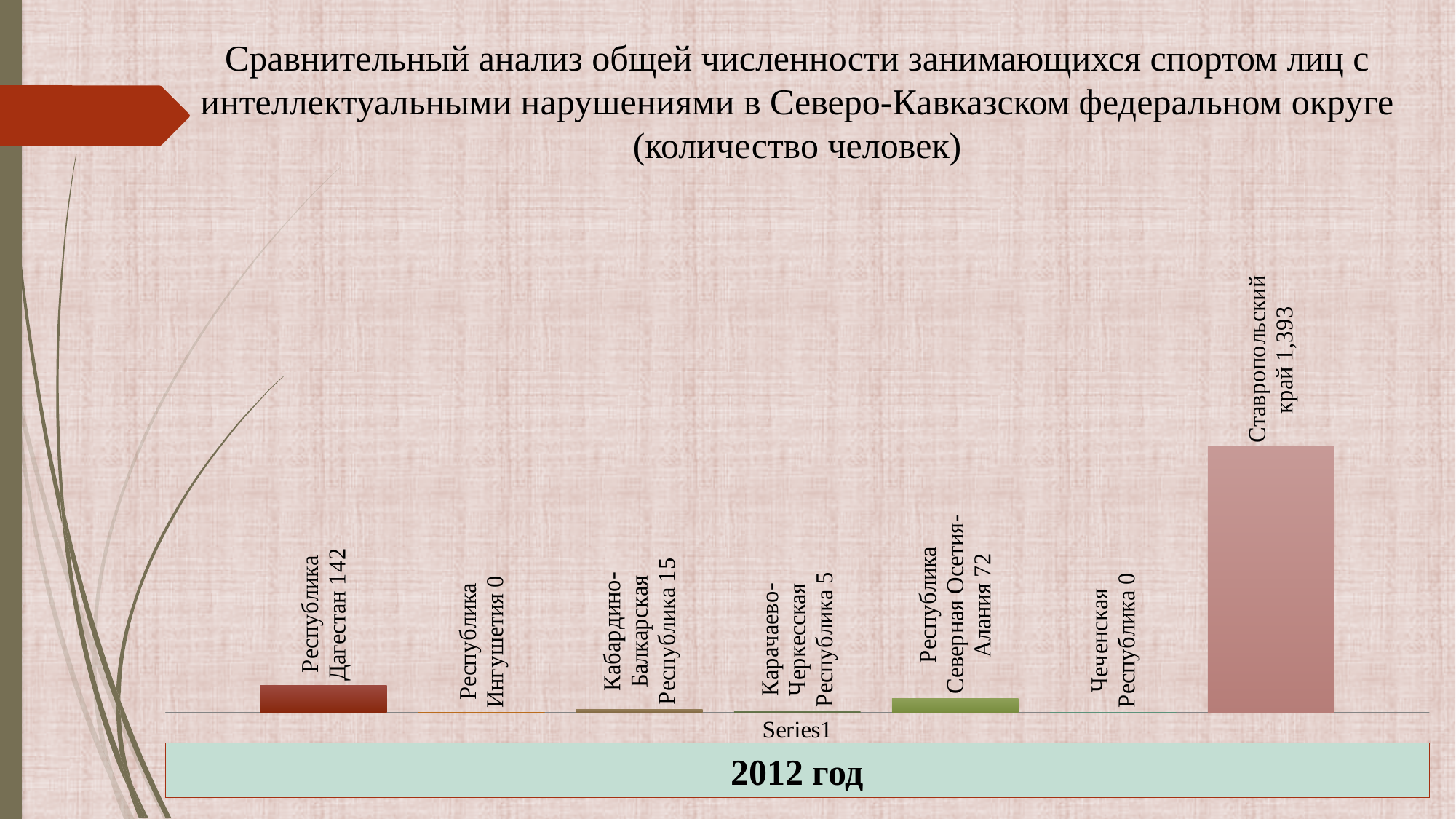
What is the value for Республика Северная Осетия-Алания? 72 What is the difference between the values for Республика Дагестан and Республика Северная Осетия-Алания? 70 Which is larger, the value for Кабардино-Балкарская Республика or Карачаево-Черкесская Республика? Кабардино-Балкарская Республика What is the value for Кабардино-Балкарская Республика? 15 Which regions have a value of 0 in the chart? Республика Ингушетия and Чеченская Республика What type of chart is shown on the slide? bar chart Which region has the highest value in the chart? Ставропольский край What year is indicated in the box below the chart? 2012 год What is the value for Республика Дагестан? 142 How many bars (regions) are plotted in the chart? 7 What is the difference between the values for Ставропольский край and Республика Дагестан? 1,251 What is the value for Ставропольский край? 1,393